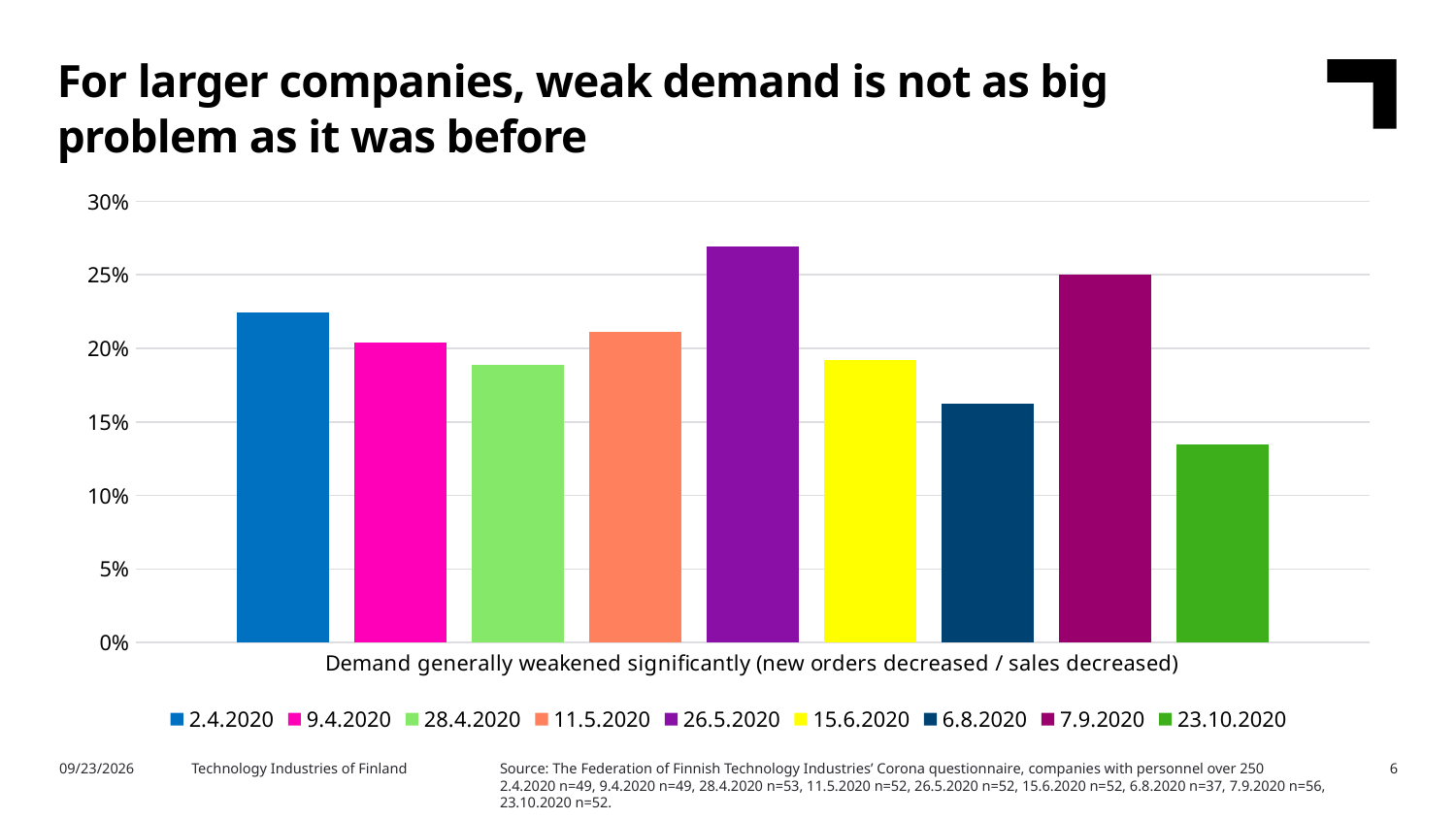
Which is larger, the value for 2.4.2020 or the value for 9.4.2020? 2.4.2020 Is the value for 2.4.2020 greater or less than 20%? greater Which survey date has the highest bar? 26.5.2020 What is the category label shown on the x axis of the chart? Demand generally weakened significantly (new orders decreased / sales decreased) What kind of chart is shown on the slide? bar chart Is the value for 6.8.2020 greater or less than 15%? greater Is the value for 23.10.2020 greater or less than 15%? less Which survey date has the lowest bar? 23.10.2020 Which is larger, the value for 7.9.2020 or the value for 6.8.2020? 7.9.2020 How many series does the legend list? 9